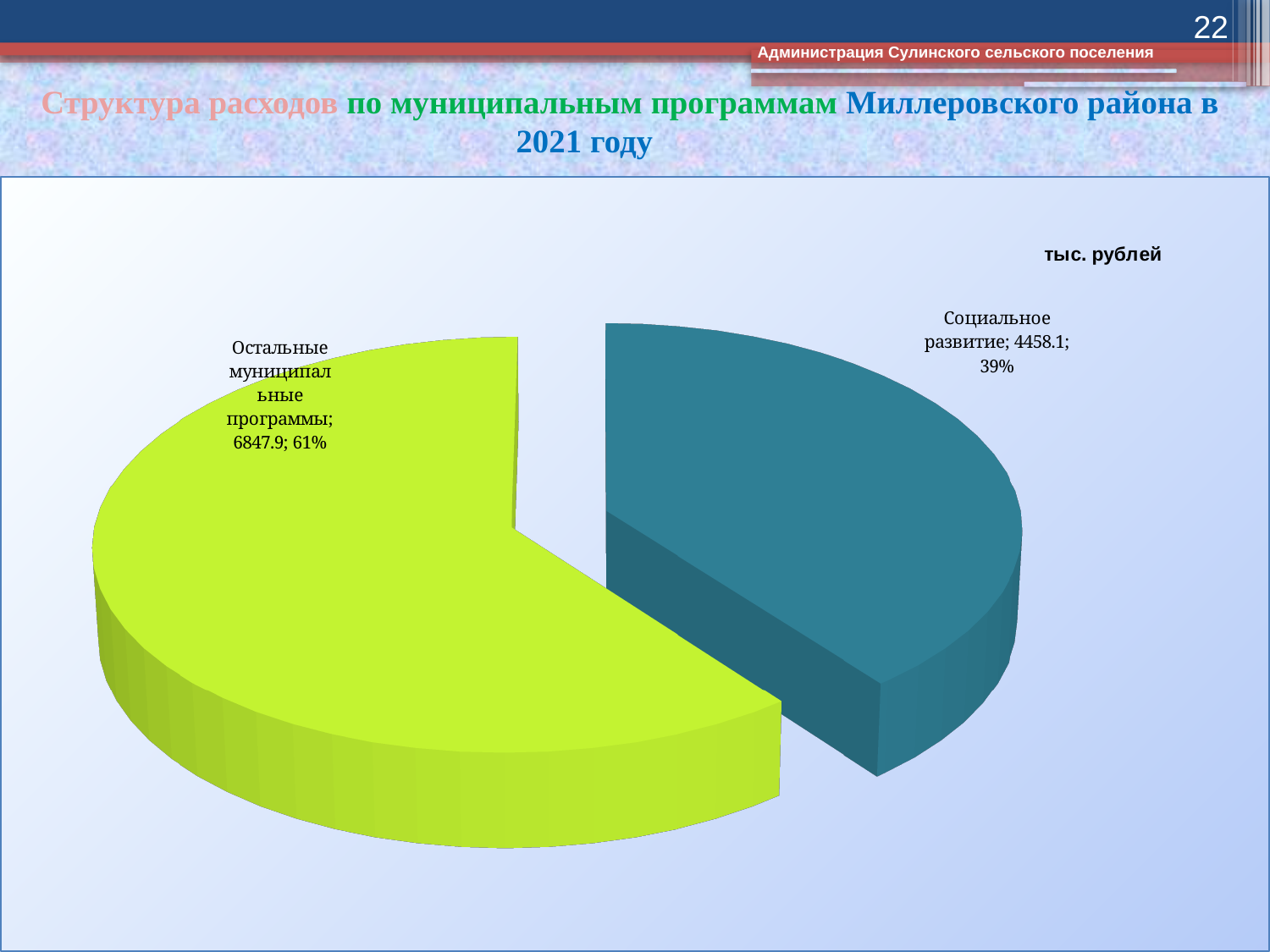
What kind of chart is shown on the slide? pie chart What share of the pie does Социальное развитие represent? 39% What unit is indicated for the chart values? тыс. рублей What share of the pie does Остальные муниципальные программы represent? 61% What is the total of the two slice values? 11306 What is the value for Остальные муниципальные программы? 6847.9 What is the value for Социальное развитие? 4458.1 How many slices does the pie chart have? 2 What is the difference between the values for Остальные муниципальные программы and Социальное развитие? 2389.8 Which slice is the largest? Остальные муниципальные программы Which is larger, Социальное развитие or Остальные муниципальные программы? Остальные муниципальные программы Which slice is the smallest? Социальное развитие